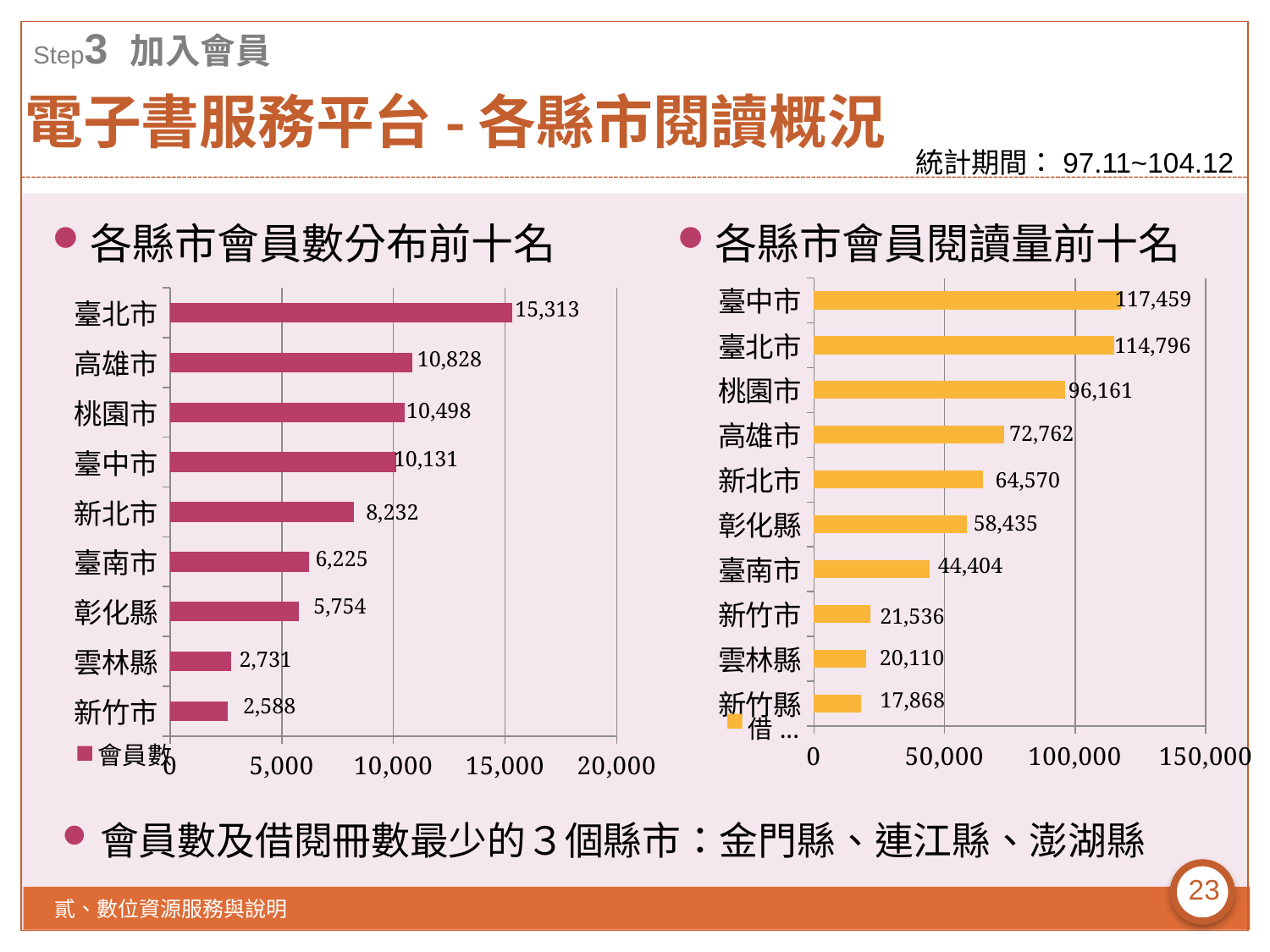
In the left chart (各縣市會員數分布前十名), what is the value for 臺北市? 15,313 In the right chart (各縣市會員閱讀量前十名), what is the value for 桃園市? 96,161 In the left chart (各縣市會員數分布前十名), which category has the lowest value? 新竹市 In the left chart (各縣市會員數分布前十名), how many categories are plotted? 9 In the left chart (各縣市會員數分布前十名), what is the value for 新北市? 8,232 In the left chart (各縣市會員數分布前十名), what is the difference between 高雄市 and 桃園市? 330 In the right chart (各縣市會員閱讀量前十名), which category has the highest value? 臺中市 In the right chart (各縣市會員閱讀量前十名), which is larger, 彰化縣 or 臺南市? 彰化縣 In the right chart (各縣市會員閱讀量前十名), what is the difference between 臺中市 and 臺北市? 2,663 What kind of chart is the right chart (各縣市會員閱讀量前十名)? Bar chart In the left chart (各縣市會員數分布前十名), what is the legend entry? 會員數 In the right chart (各縣市會員閱讀量前十名), how many categories are plotted? 10